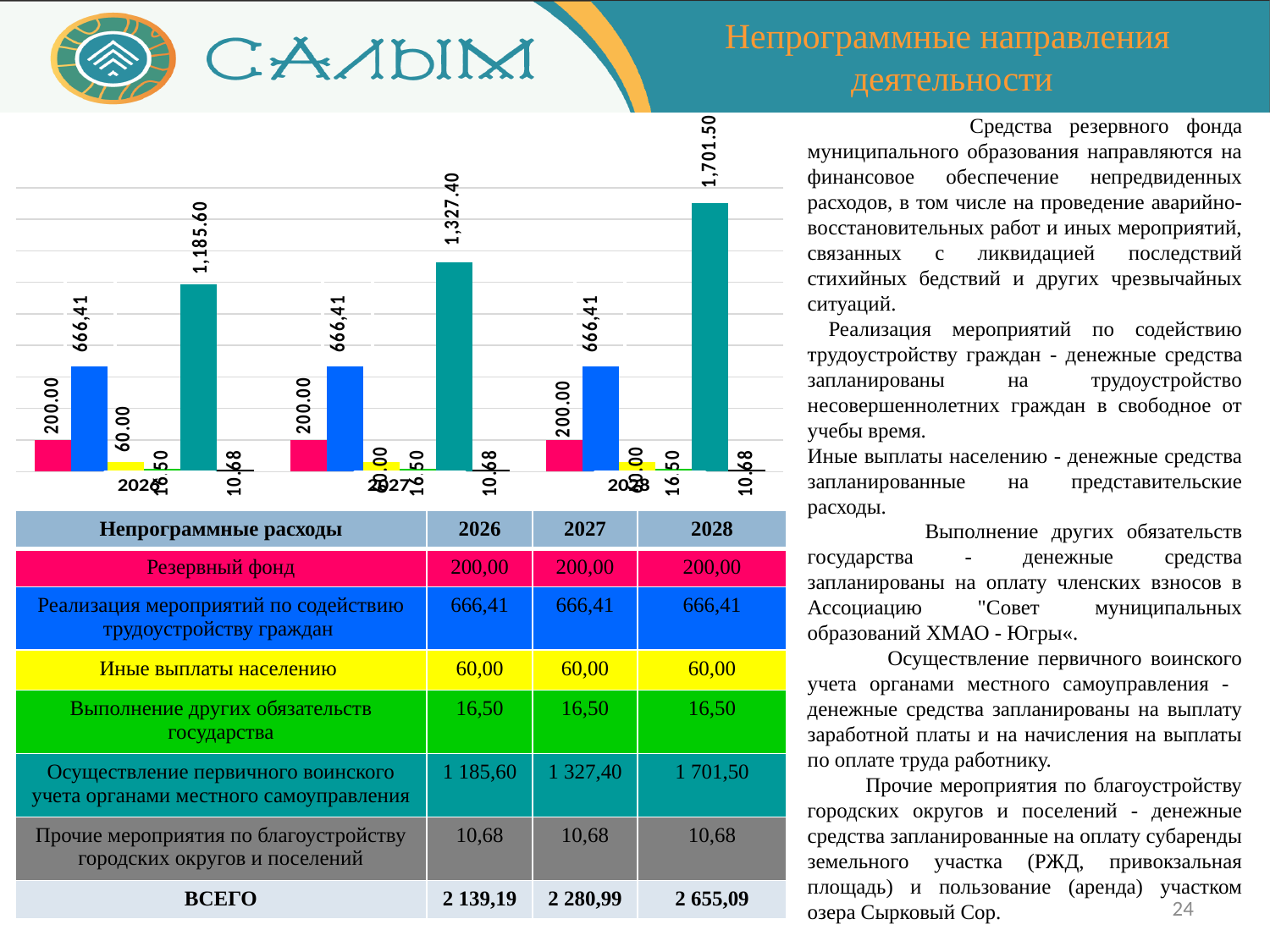
How many year groups are shown on the x axis of the chart? 3 Which year group has the lowest teal bar? 2026 What is the value of the teal bar in the 2026 group? 1,185.60 What is the difference between the teal bar values for 2028 and 2026? 515.90 What is the value of the blue bar in the 2027 group? 666.41 Which year group has the highest teal bar? 2028 What is the value of the teal bar in the 2027 group? 1,327.40 Does the teal bar value rise or fall from 2026 to 2028? rise What kind of chart is shown on the slide? bar chart What is the value of the pink (red) bar in the 2026 group? 200.00 Which is larger in the 2026 group: the blue bar or the pink bar? the blue bar (666.41) What is the value of the tallest (teal) bar in the 2028 group? 1,701.50